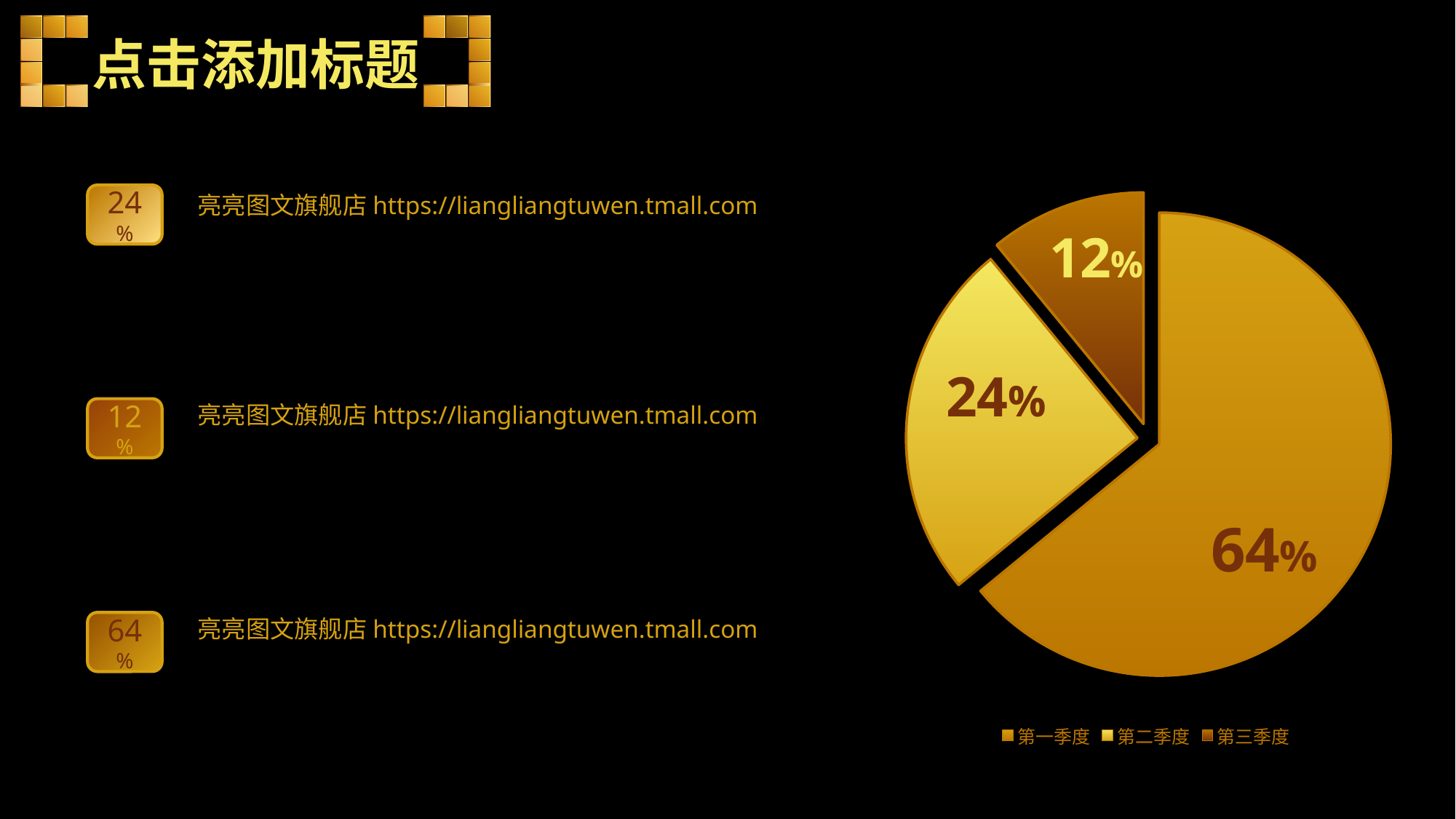
How many entries does the pie chart's legend list? 3 What is the difference in percentage points between the 第二季度 slice and the 第三季度 slice? 12 Which slice of the pie chart is the smallest? 第三季度 Which is larger, the 第二季度 slice or the 第三季度 slice? 第二季度 What share of the pie does 第三季度 represent? 12% What are the three legend entries of the pie chart, in order? 第一季度, 第二季度, 第三季度 What is the difference in percentage points between the 第一季度 slice and the 第二季度 slice? 40 What type of chart is shown on the slide? pie chart Which slice of the pie chart is the largest? 第一季度 How many slices does the pie chart have? 3 What share of the pie does 第一季度 represent? 64% What share of the pie does 第二季度 represent? 24%